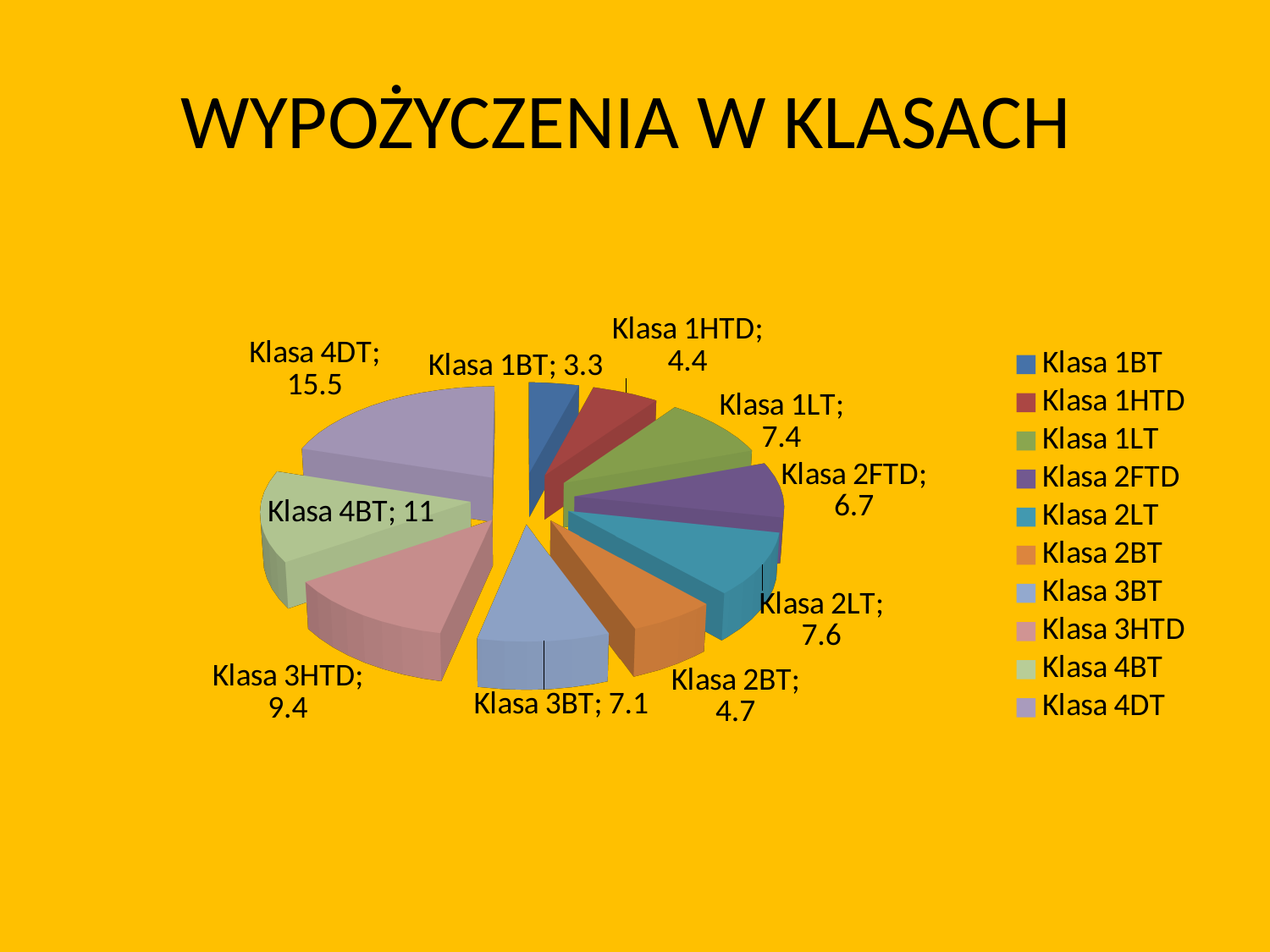
What is the value for Klasa 3BT? 7.1 Which is larger, the value for Klasa 2LT or Klasa 1LT? Klasa 2LT What is the difference between the values for Klasa 3HTD and Klasa 2BT? 4.7 What is the title of the slide? WYPOŻYCZENIA W KLASACH What is the value for Klasa 4DT? 15.5 What type of chart is shown on the slide? pie chart What is the value for Klasa 2FTD? 6.7 Which class has the largest slice of the pie? Klasa 4DT How many slices does the pie chart have? 10 What is the value for Klasa 3HTD? 9.4 What is the difference between the values for Klasa 4DT and Klasa 4BT? 4.5 Which class has the smallest slice of the pie? Klasa 1BT